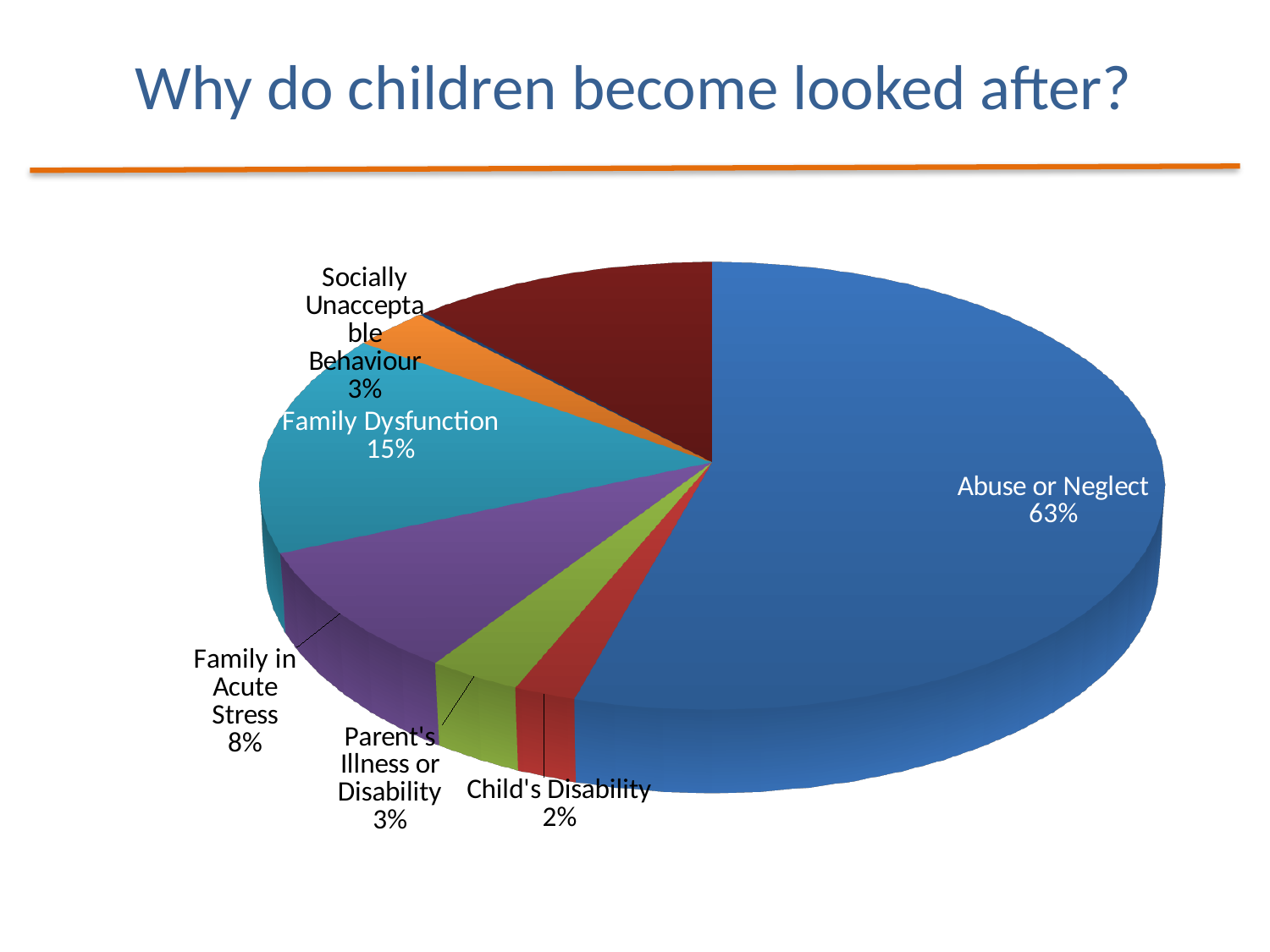
What percentage of the pie is labelled Abuse or Neglect? 63% Which is larger, Family in Acute Stress or Parent's Illness or Disability? Family in Acute Stress What value is shown for Family Dysfunction? 15% How many percentage points larger is Abuse or Neglect than Family Dysfunction? 48 percentage points Which labelled category has the largest slice of the pie? Abuse or Neglect What percentage is given for Family in Acute Stress? 8% What percentage is shown for Socially Unacceptable Behaviour? 3% What is the title of the slide? Why do children become looked after? What kind of chart is shown on the slide? Pie chart What value is shown for Child's Disability? 2% Which labelled category has the smallest slice of the pie? Child's Disability